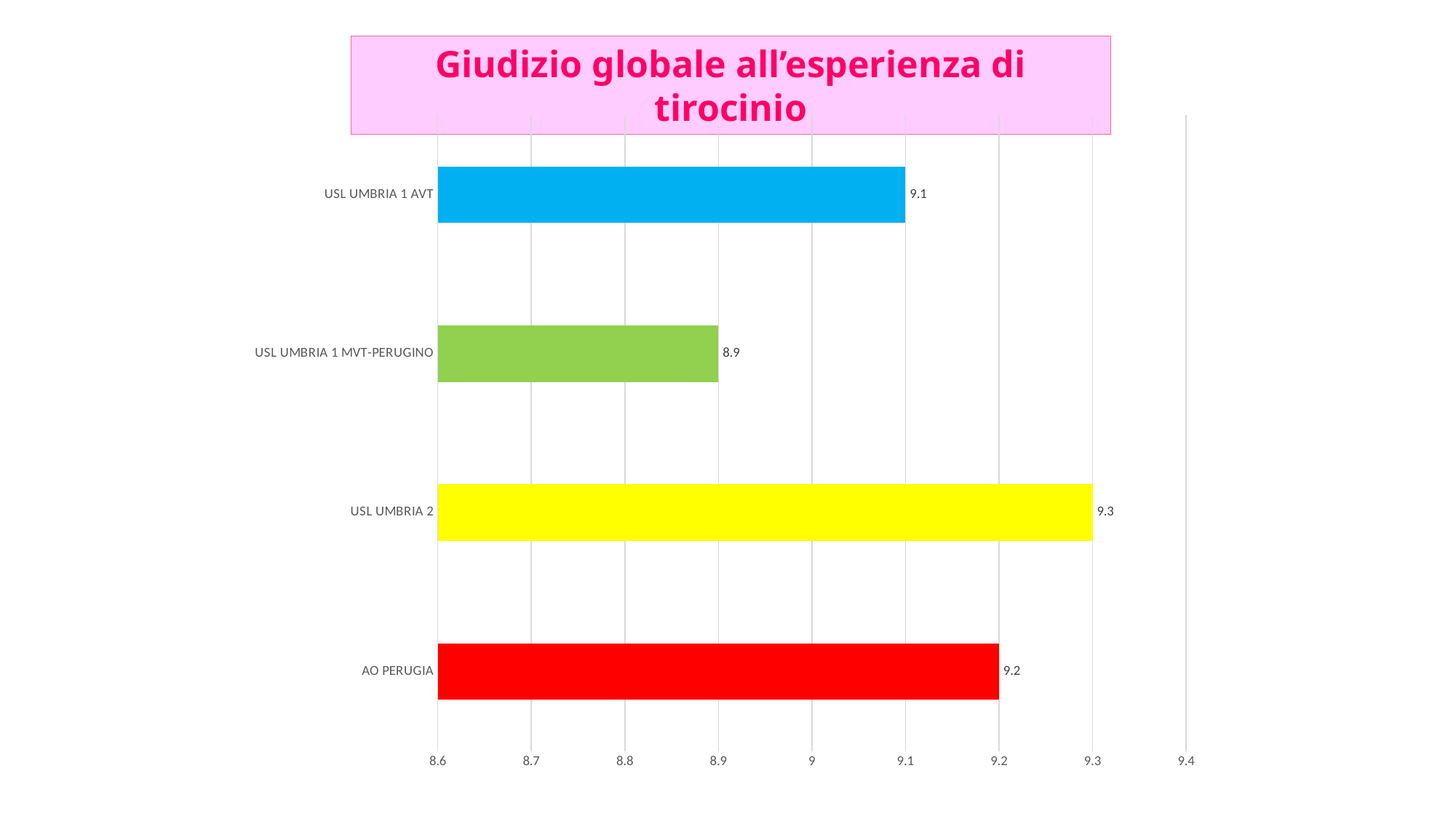
Is the value for USL UMBRIA 1 MVT-PERUGINO greater or less than 9? less What is the value for USL UMBRIA 2? 9.3 What kind of chart is shown on the slide? bar chart What is the value for AO PERUGIA? 9.2 How many categories are shown in the chart? 4 What is the value for USL UMBRIA 1 AVT? 9.1 What is the title of the chart? Giudizio globale all'esperienza di tirocinio What is the value for USL UMBRIA 1 MVT-PERUGINO? 8.9 Which has a larger value, AO PERUGIA or USL UMBRIA 1 AVT? AO PERUGIA What is the difference between the values for USL UMBRIA 2 and USL UMBRIA 1 MVT-PERUGINO? 0.4 Which category has the lowest value? USL UMBRIA 1 MVT-PERUGINO Which category has the highest value? USL UMBRIA 2